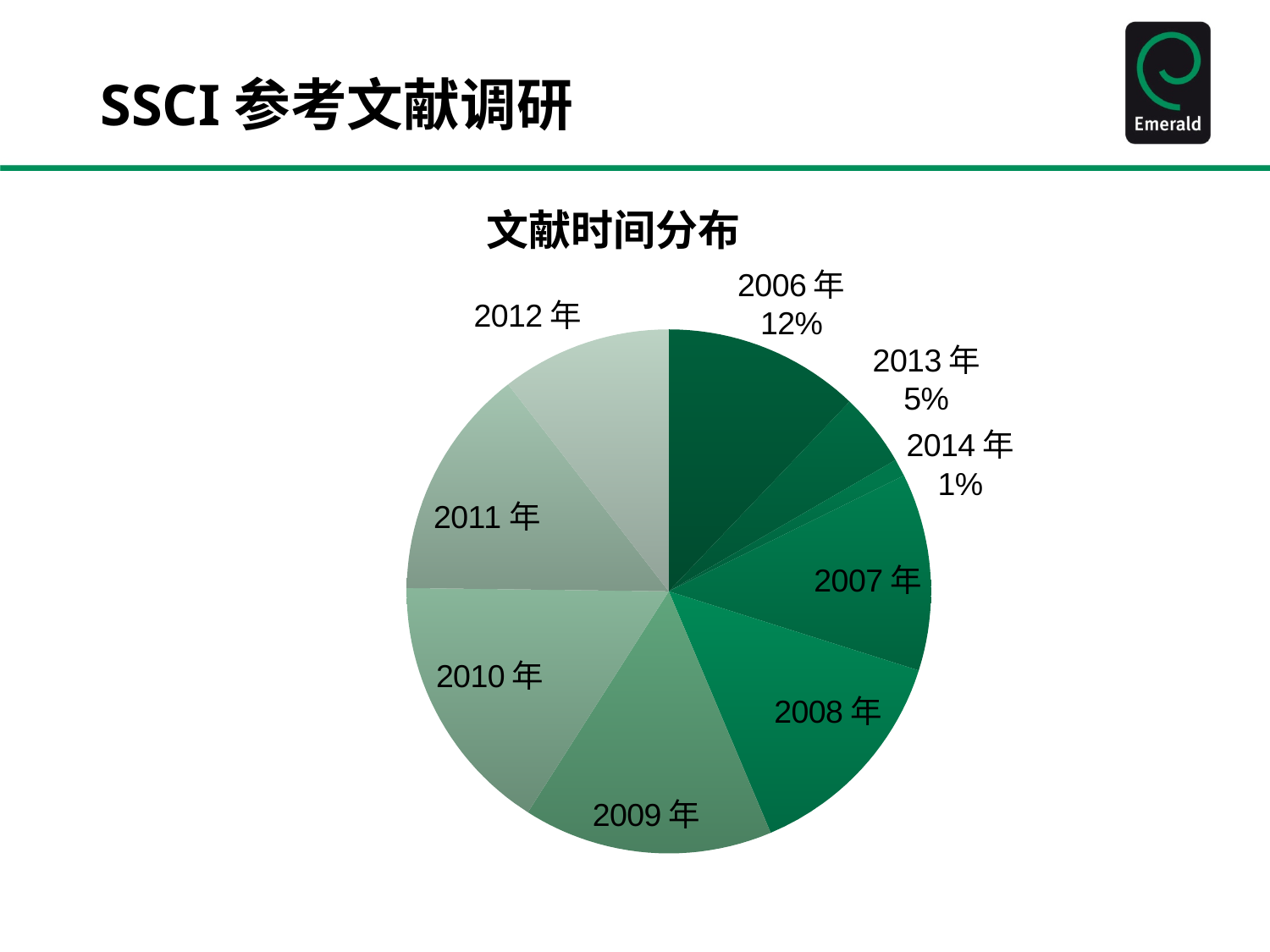
What is the difference in percentage points between the 2013 年 and 2014 年 slices? 4% Which slice is larger, 2006 年 or 2014 年? 2006 年 What share of the pie does 2013 年 have? 5% Which year has the smallest slice of the pie? 2014 年 What share of the pie does 2006 年 have? 12% What is the difference in percentage points between the 2006 年 and 2013 年 slices? 7% What kind of chart is shown on the slide? pie chart Which slice is larger, 2006 年 or 2013 年? 2006 年 What is the title of the chart? 文献时间分布 How many slices does the pie chart have? 9 Which slice is larger, 2009 年 or 2014 年? 2009 年 What share of the pie does 2014 年 have? 1%